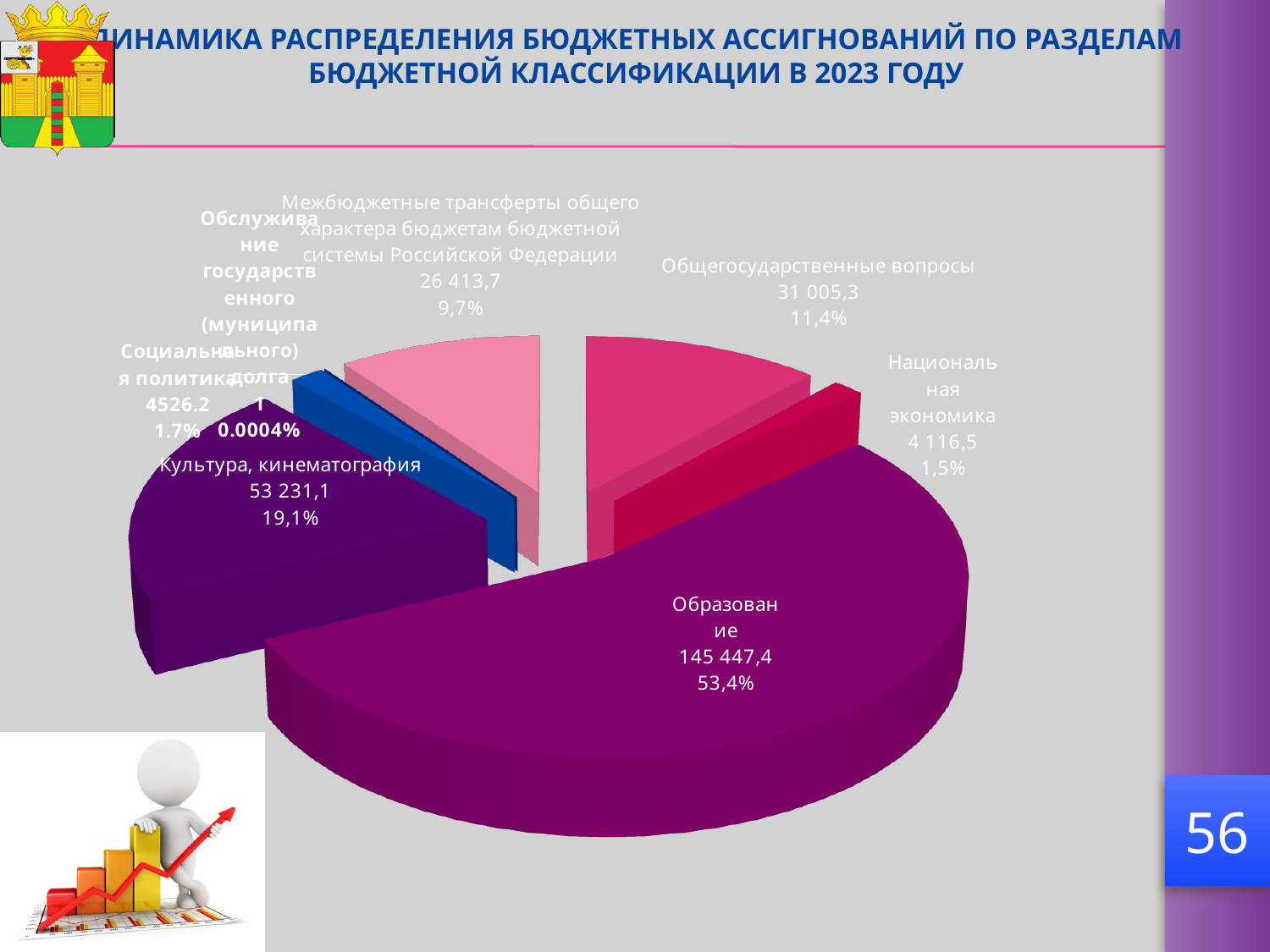
How many categories (slices) does the pie chart show? 7 What kind of chart is shown on the slide? pie chart What is the difference in percentage points between Образование (53,4%) and Культура, кинематография (19,1%)? 34,3 What percentage is shown for Общегосударственные вопросы? 11,4% What share of the pie does Образование represent? 53,4% Which category has the largest slice of the pie? Образование What is the value shown for Образование? 145 447,4 What is the value shown for Культура, кинематография? 53 231,1 What is the value shown for Национальная экономика? 4 116,5 Which is larger: Общегосударственные вопросы or Национальная экономика? Общегосударственные вопросы Which category has the smallest slice of the pie? Обслуживание государственного (муниципального) долга What percentage is shown for Межбюджетные трансферты общего характера бюджетам бюджетной системы Российской Федерации? 9,7%